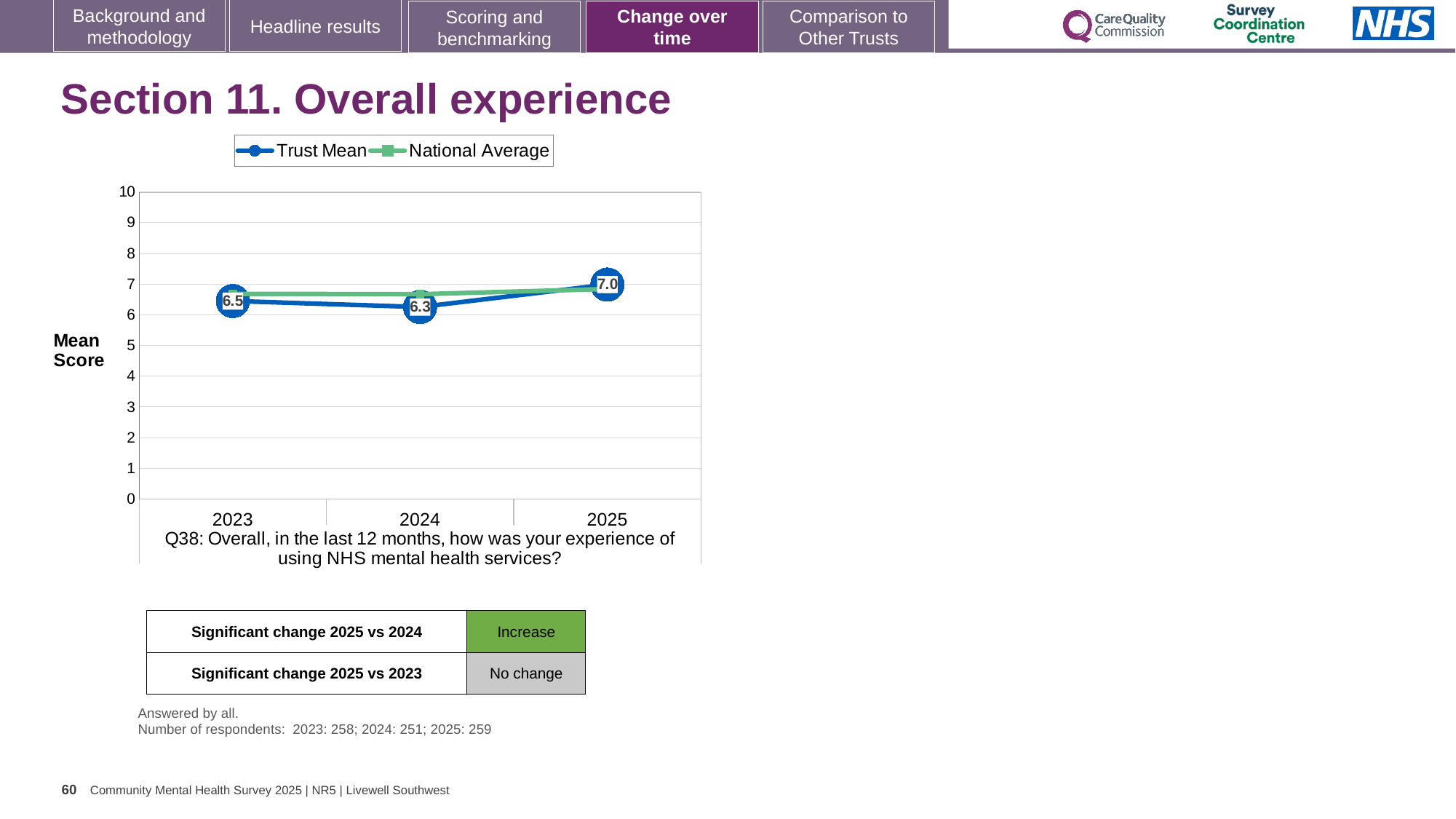
Is the National Average value for 2024 greater or less than 6? greater What is the Trust Mean score for 2024? 6.3 What is the Trust Mean score for 2025? 7.0 What kind of chart is shown on the slide? Line chart Which is larger in 2024, the Trust Mean or the National Average? National Average What is the Trust Mean score for 2023? 6.5 By how much did the Trust Mean score change from 2024 to 2025? 0.7 Does the Trust Mean score rise or fall from 2024 to 2025? Rise In which year is the Trust Mean score lowest? 2024 How many series does the chart legend list? 2 In which year is the Trust Mean score highest? 2025 How many years are shown on the x axis of the chart? 3